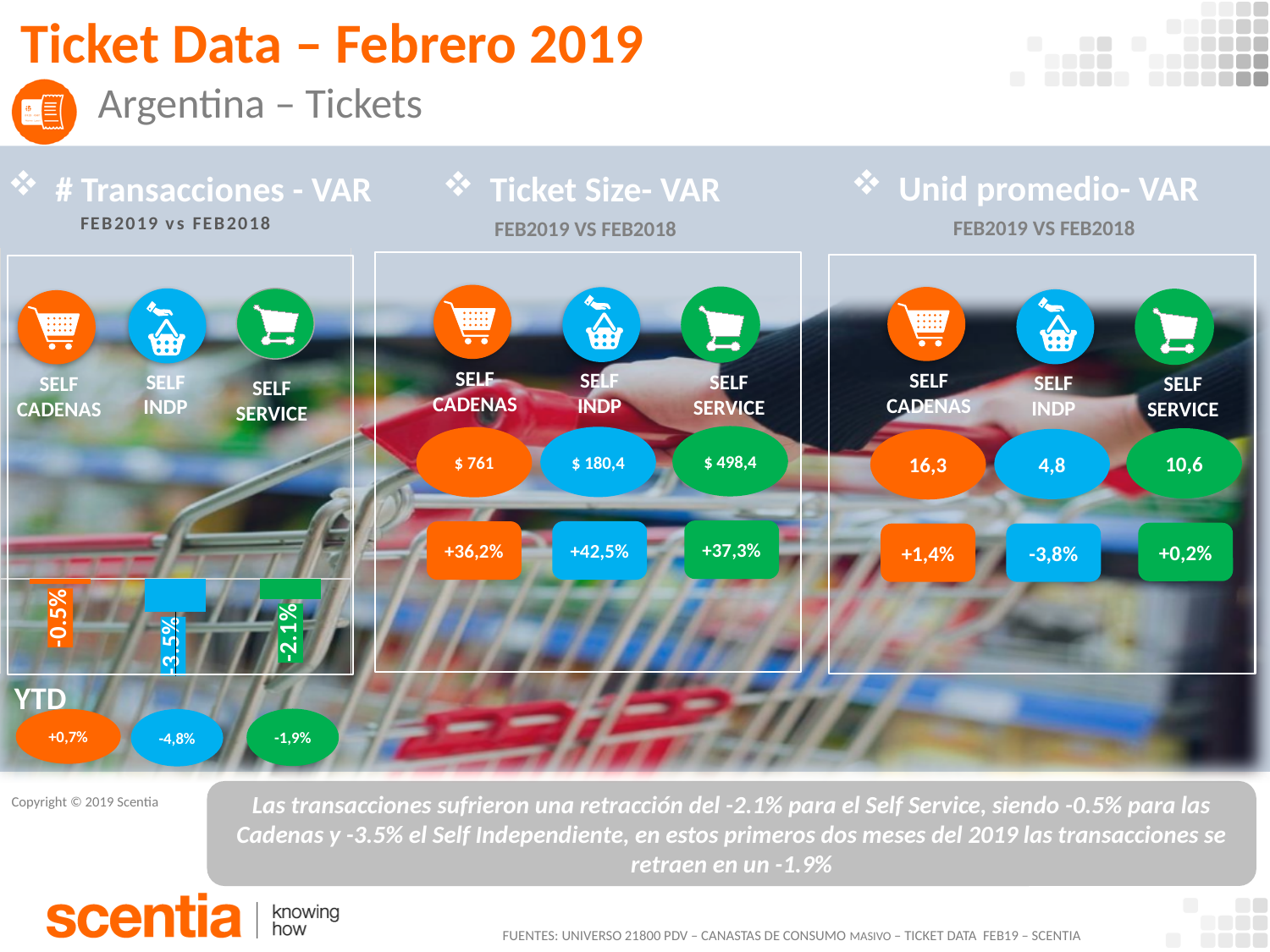
In the '# Transacciones - VAR' bar chart, what is the value for Self Service? -2.1% How many categories are shown in the '# Transacciones - VAR' bar chart? 3 In the '# Transacciones - VAR' bar chart, what colour is the Self Indp bar? Blue In the '# Transacciones - VAR' bar chart, what is the value for Self Indp? -3.5% In the '# Transacciones - VAR' bar chart, what is the value for Self Cadenas? -0.5% In the '# Transacciones - VAR' bar chart, which category has the highest value? Self Cadenas In the '# Transacciones - VAR' bar chart, what is the difference between the values for Self Cadenas and Self Indp? 3.0 percentage points In the '# Transacciones - VAR' bar chart, what is the difference between the values for Self Service and Self Indp? 1.4 percentage points In the '# Transacciones - VAR' bar chart, which is larger, the value for Self Cadenas or the value for Self Service? Self Cadenas What kind of chart is the '# Transacciones - VAR' chart? Bar chart What comparison period is shown under the '# Transacciones - VAR' chart title? FEB2019 vs FEB2018 In the '# Transacciones - VAR' bar chart, which category has the lowest value? Self Indp